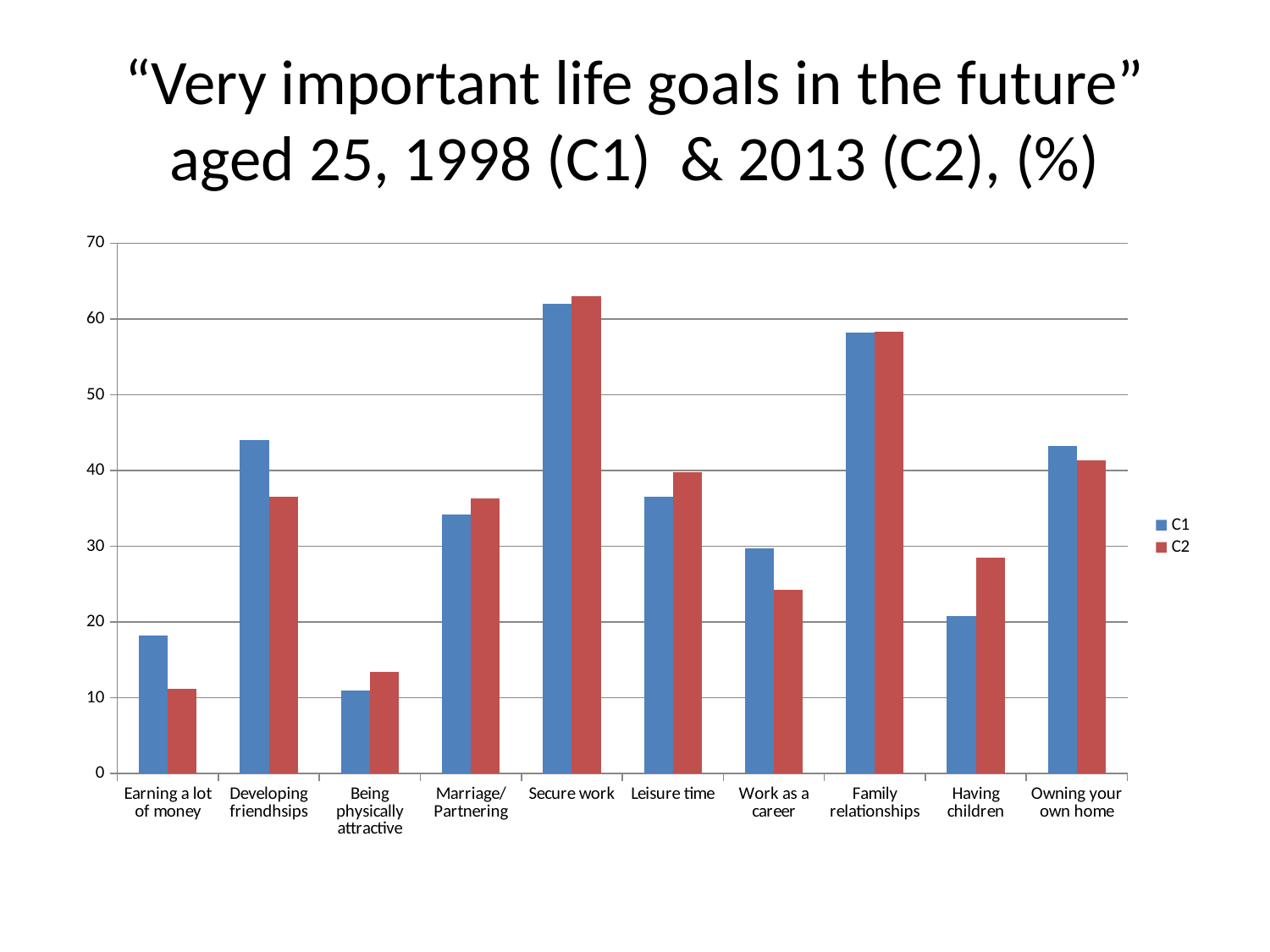
What kind of chart is shown on the slide? bar chart Which category has the lowest C1 value? Being physically attractive For Developing friendhsips, which series has the larger value, C1 or C2? C1 For Work as a career, which series has the larger value, C1 or C2? C1 How many life-goal categories are shown on the x axis? 10 Is the C1 value for Secure work greater or less than 60? greater For Having children, which series has the larger value, C1 or C2? C2 Which category has the highest C2 value? Secure work Which series is shown in red in the legend? C2 Which category has the highest C1 value? Secure work How many series does the legend list? 2 Is the C2 value for Work as a career greater or less than 30? less